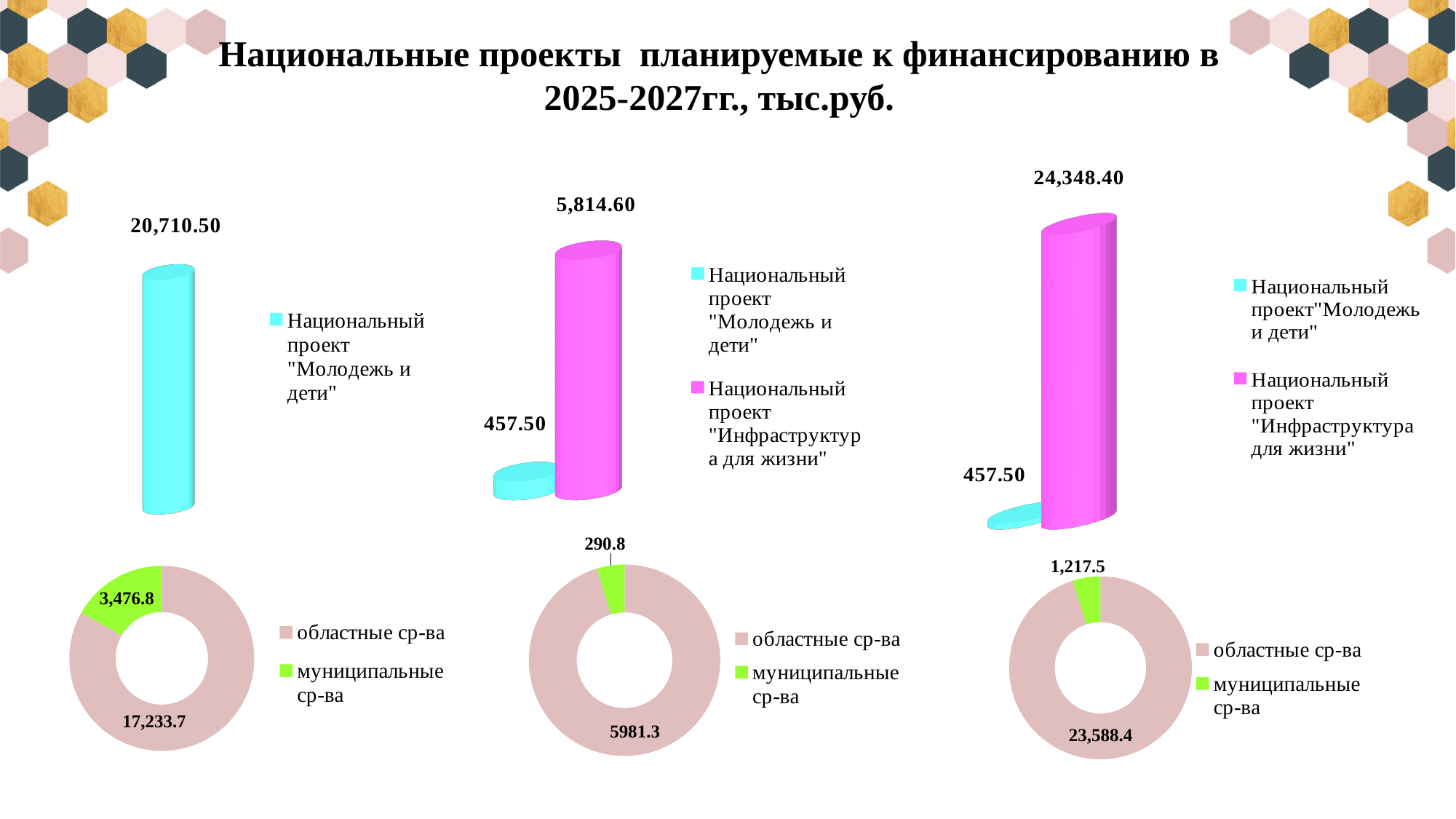
In the bottom-right doughnut chart, which category is larger: областные ср-ва or муниципальные ср-ва? областные ср-ва In the top-middle bar chart, what is the difference between the values for "Инфраструктура для жизни" and "Молодежь и дети"? 5,357.10 In the top-right bar chart, what is the difference between the values for "Инфраструктура для жизни" and "Молодежь и дети"? 23,890.90 In the top-left bar chart, what is the value for Национальный проект "Молодежь и дети"? 20,710.50 In the top-right bar chart, which series has the highest value? Национальный проект "Инфраструктура для жизни" What kind of chart is the bottom-left chart? Doughnut chart In the top-right bar chart, what is the value for Национальный проект "Молодежь и дети"? 457.50 In the bottom-left doughnut chart, what is the value for муниципальные ср-ва? 3,476.8 In the bottom-right doughnut chart, what is the total of областные ср-ва and муниципальные ср-ва? 24,805.9 In the bottom-middle doughnut chart, what is the value for областные ср-ва? 5981.3 How many series does the legend of the top-middle bar chart list? 2 In the top-middle bar chart, what is the value for Национальный проект "Инфраструктура для жизни"? 5,814.60